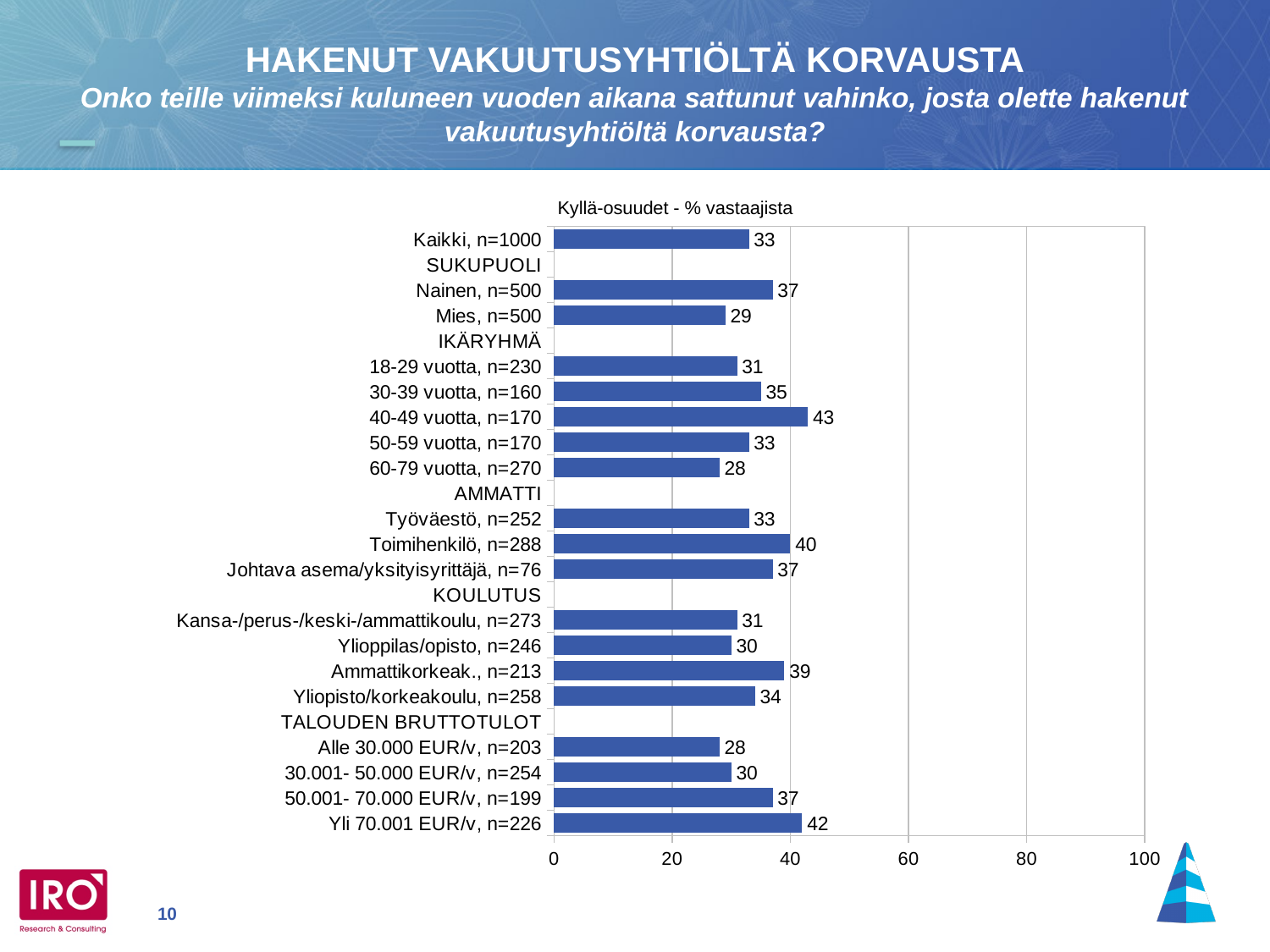
What is the value for Kaikki, n=1000? 33 How many bars are plotted in the chart? 19 Which category has the highest value in the chart? 40-49 vuotta, n=170 Which is larger, the value for Toimihenkilö, n=288 or Työväestö, n=252? Toimihenkilö, n=288 Among the age groups (IKÄRYHMÄ), which has the lowest value? 60-79 vuotta, n=270 What is the value for 40-49 vuotta, n=170? 43 What is the value for Nainen, n=500? 37 What is the value for Yli 70.001 EUR/v, n=226? 42 What is the difference between the values for Nainen, n=500 and Mies, n=500? 8 What is the title shown above the chart? Kyllä-osuudet - % vastaajista What kind of chart is shown on the slide? Bar chart Is the value for Ammattikorkeak., n=213 greater or less than 20? greater